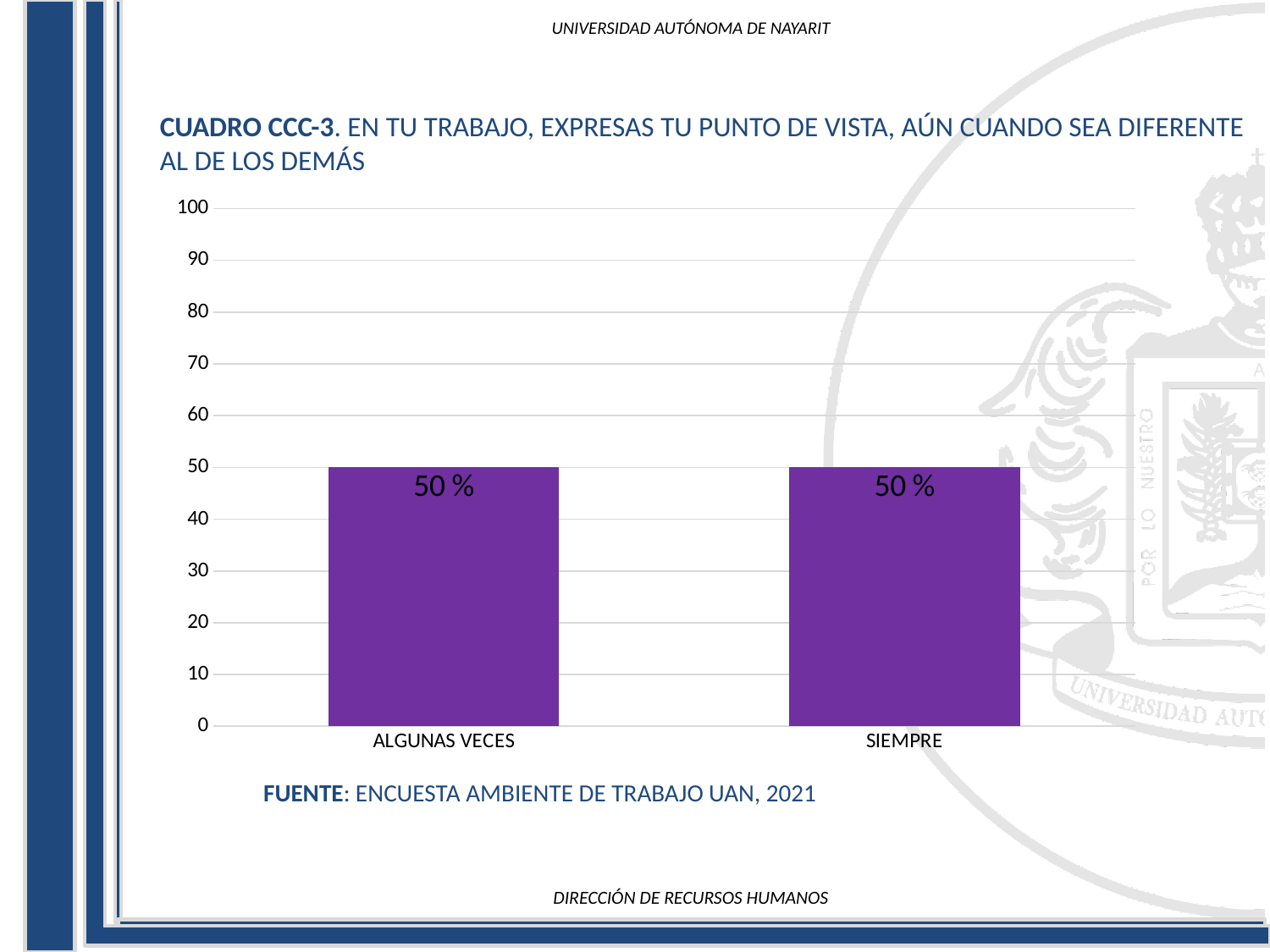
What kind of chart is shown on the slide? bar chart How many categories are shown on the x axis? 2 Is the value for SIEMPRE greater or less than 60? less What is the difference between the values for ALGUNAS VECES and SIEMPRE? 0 What is the value for SIEMPRE? 50 % Is the value for ALGUNAS VECES greater or less than 40? greater What source is cited below the chart? ENCUESTA AMBIENTE DE TRABAJO UAN, 2021 What is the value for ALGUNAS VECES? 50 % What is the maximum value shown on the y axis? 100 What is the total of the values for ALGUNAS VECES and SIEMPRE? 100 %